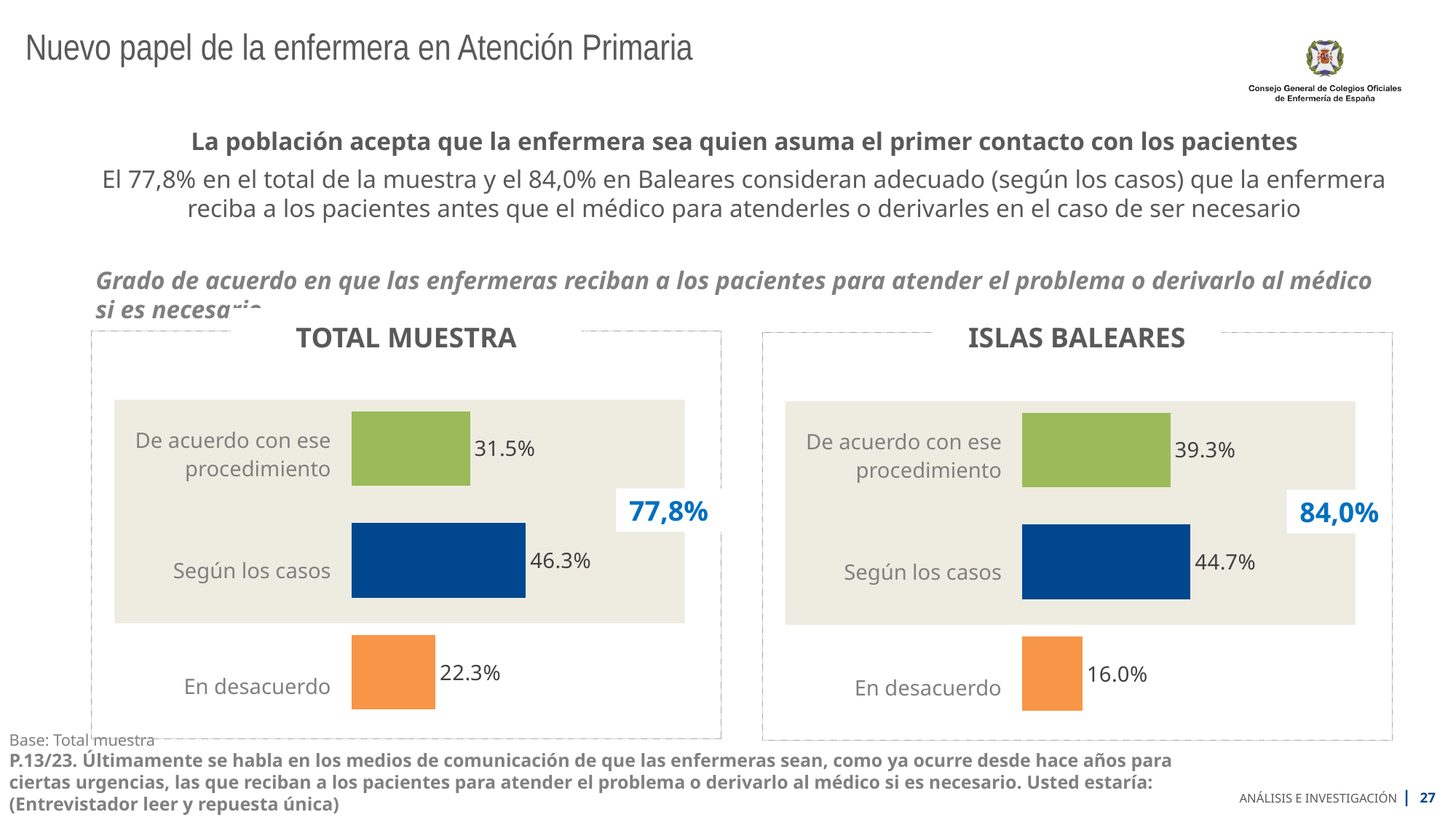
In the TOTAL MUESTRA chart, what colour is the bar for "En desacuerdo"? Orange What combined percentage is highlighted in blue next to the ISLAS BALEARES chart? 84,0% In the TOTAL MUESTRA chart, which category has the highest value? Según los casos How many categories does the TOTAL MUESTRA chart show? 3 In the ISLAS BALEARES chart, what is the difference between "Según los casos" and "En desacuerdo"? 28.7% What kind of chart is the ISLAS BALEARES chart? Bar chart In the TOTAL MUESTRA chart, what is the value for "Según los casos"? 46.3% In the ISLAS BALEARES chart, which category has the lowest value? En desacuerdo In the TOTAL MUESTRA chart, what is the difference between "Según los casos" and "De acuerdo con ese procedimiento"? 14.8% In the ISLAS BALEARES chart, what is the value for "En desacuerdo"? 16.0% In the ISLAS BALEARES chart, what is the value for "De acuerdo con ese procedimiento"? 39.3% Which is larger: "En desacuerdo" in the TOTAL MUESTRA chart or "En desacuerdo" in the ISLAS BALEARES chart? TOTAL MUESTRA